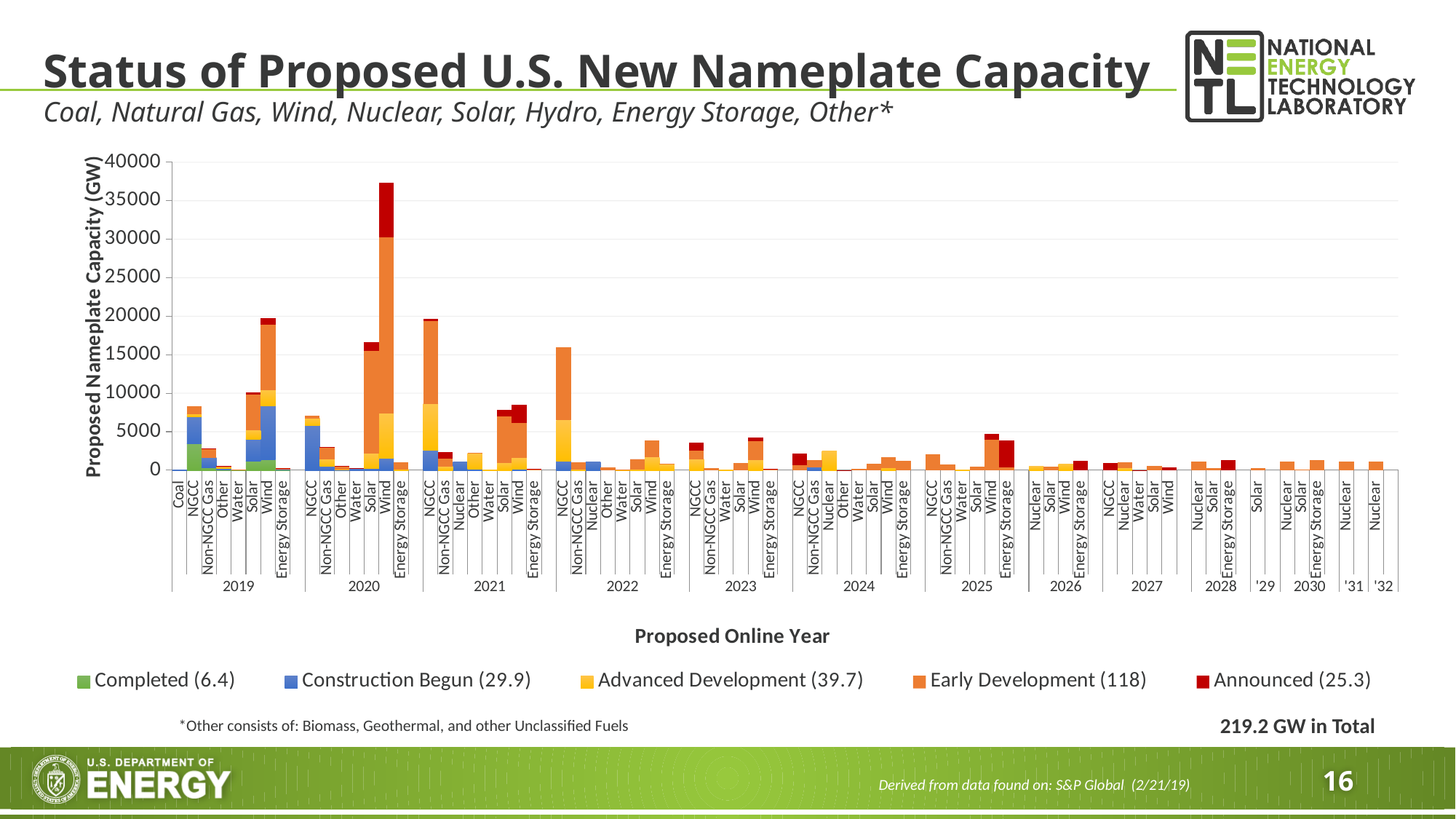
What total in GW does the legend give for the Early Development series? 118 Which is larger, the bar for Wind in 2019 or the bar for Solar in 2020? Wind in 2019 What kind of chart is shown on the slide? Stacked bar chart How many fuel categories are shown under the year 2019? 8 How many series does the legend list? 5 Is the value for Wind in 2020 greater or less than 35000? greater Which bar is the highest in the chart? Wind in 2020 Is the value for NGCC in 2022 greater or less than 10000? greater Is the value for NGCC in 2021 greater or less than 15000? greater Which is larger, the bar for Wind in 2020 or the bar for NGCC in 2021? Wind in 2020 Do the bar heights generally rise or fall as the proposed online year increases along the x axis? fall